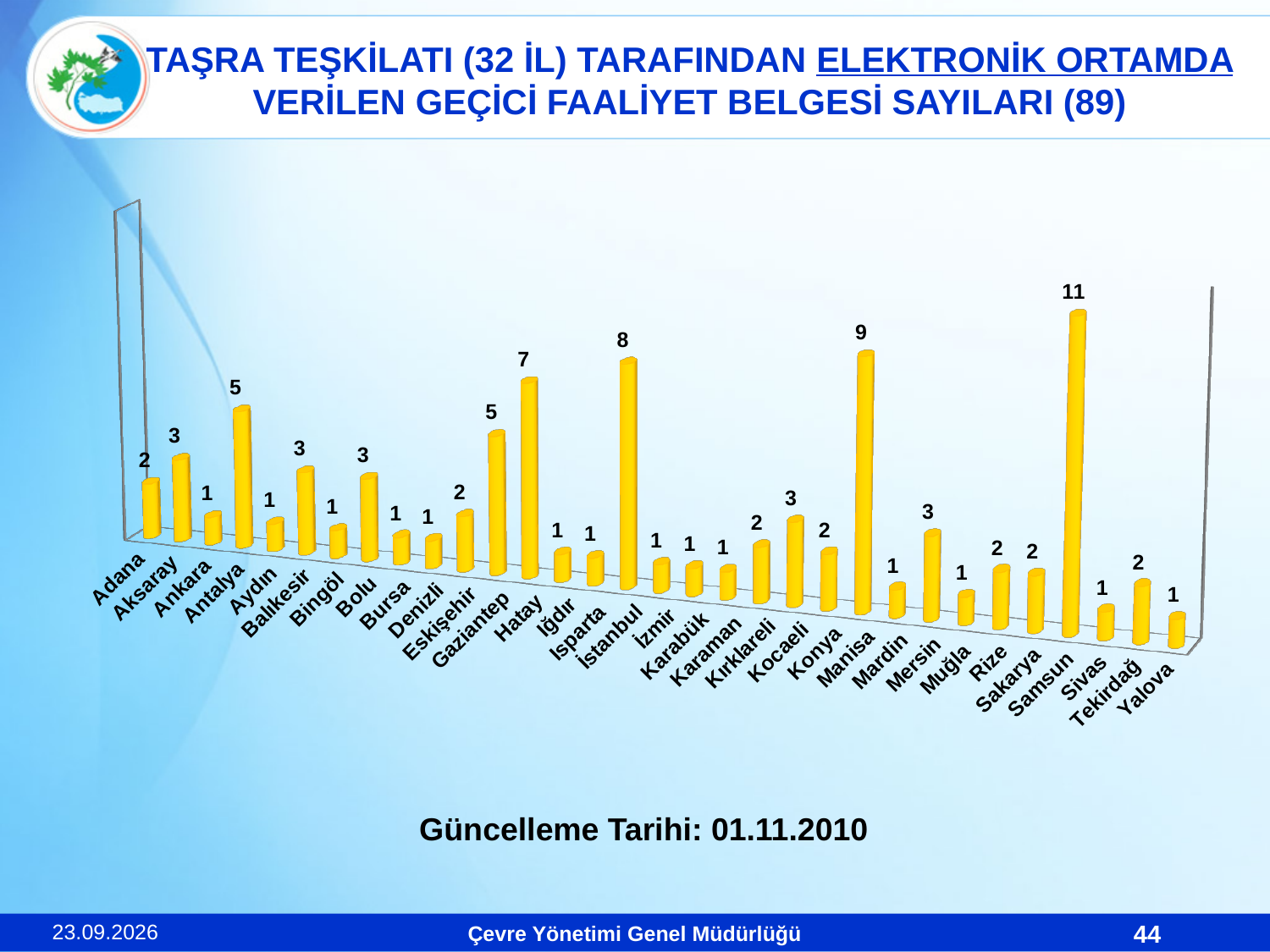
How many provinces are shown on the x axis? 32 Which province has the highest value? Samsun What kind of chart is shown on the slide? Bar chart What is the difference between the values for İstanbul and Hatay? 1 What is the value for Hatay? 7 What is the value for Samsun? 11 Which is larger, the value for Gaziantep or the value for Kocaeli? Gaziantep What is the value for Manisa? 9 What is the value for Antalya? 5 What update date (Güncelleme Tarihi) is shown below the chart? 01.11.2010 What is the difference between the values for Samsun and Manisa? 2 What is the value for İstanbul? 8